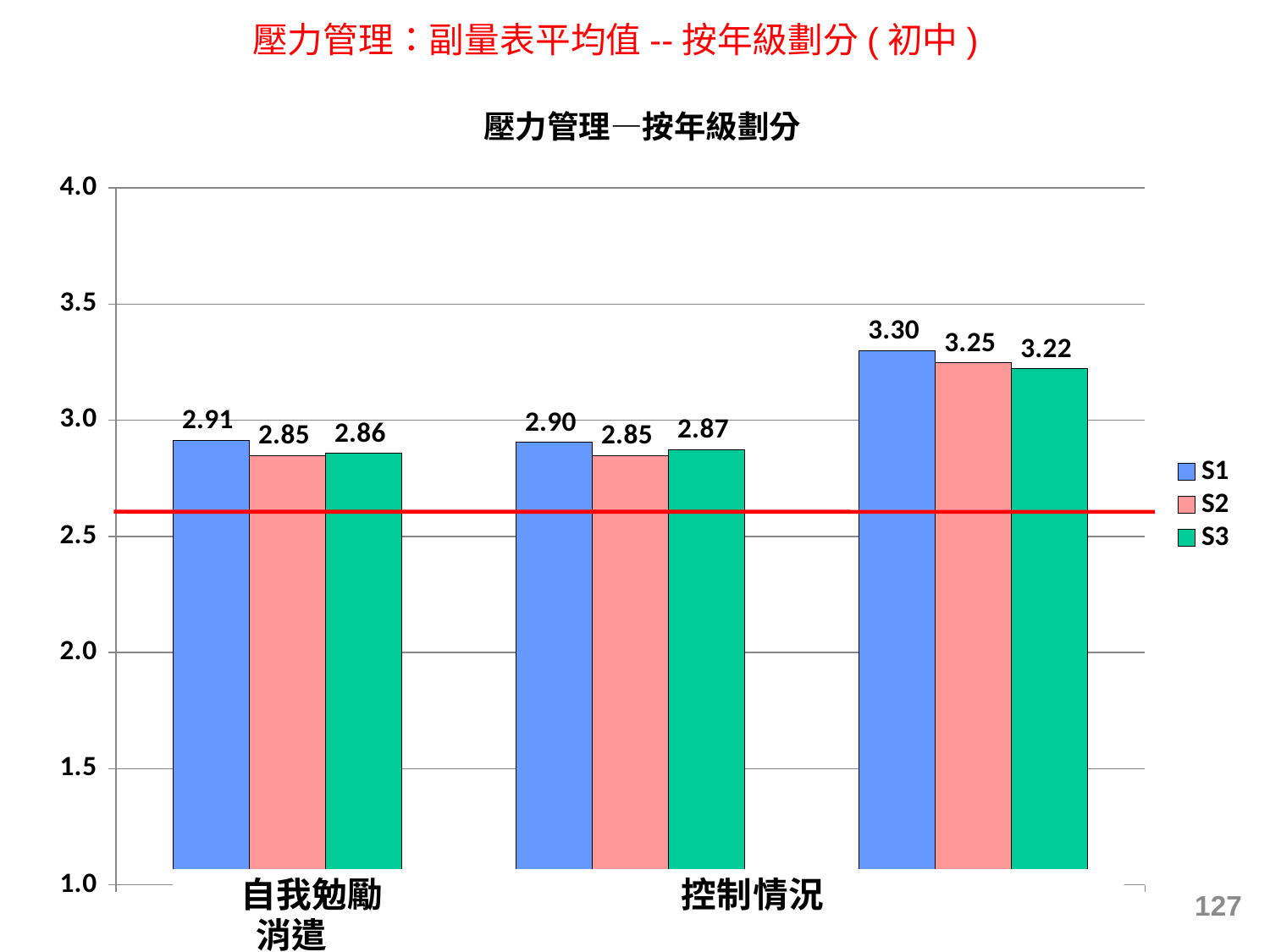
What is the title of the chart? 壓力管理─按年級劃分 What is the difference between S3 and S2 for 控制情況? 0.02 How many series does the legend list? 3 What kind of chart is shown on the slide? bar chart What is the value of S1 for 控制情況? 2.90 What is the value of S3 for 控制情況? 2.87